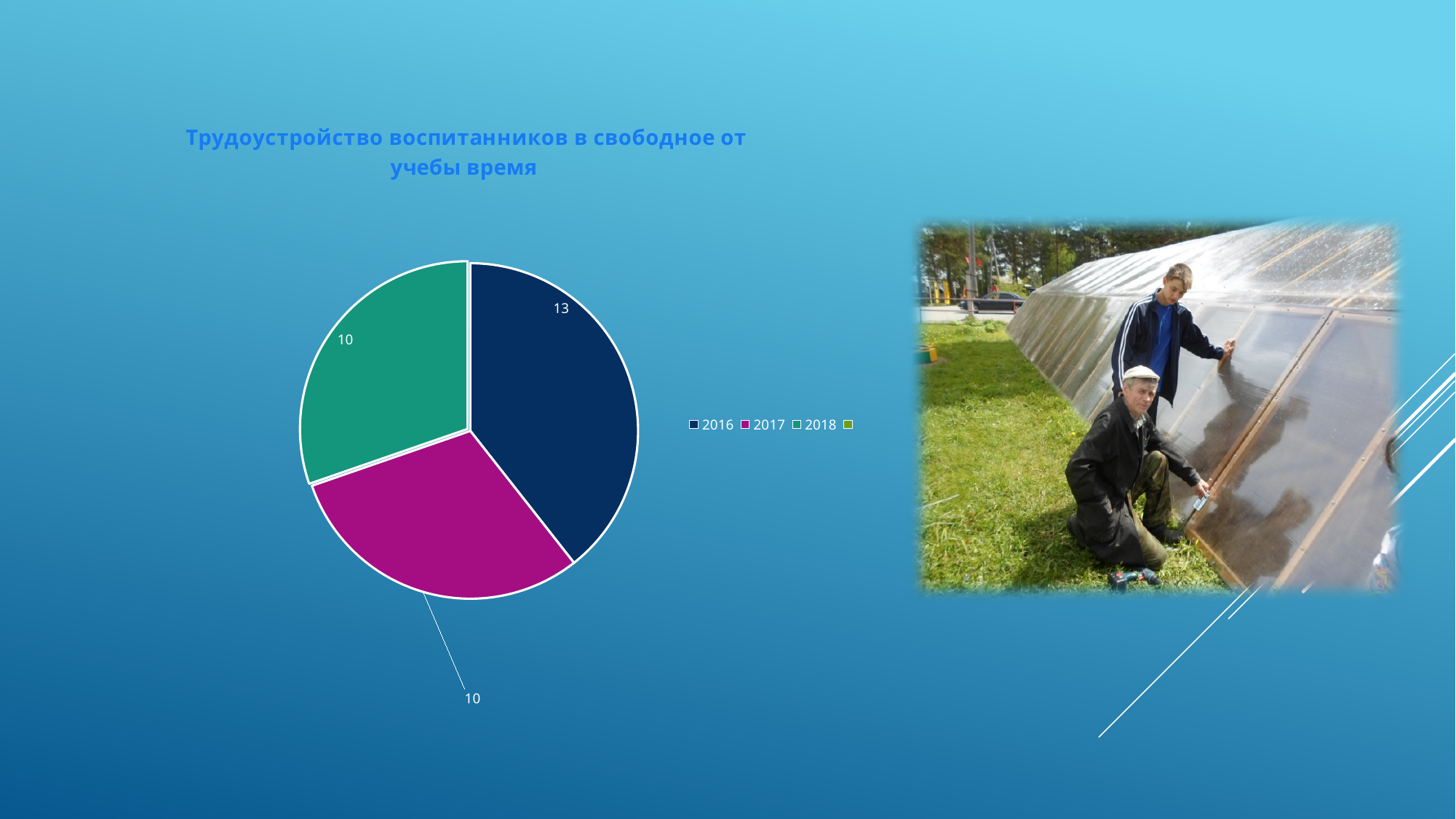
What is the difference between the values for 2016 and 2018? 3 What colour is the slice for 2017? magenta How many slices does the pie chart have? 3 Which year has the largest slice in the pie chart? 2016 What is the total of all the slices in the pie chart? 33 What is the value for 2016 in the pie chart? 13 What is the value for 2018 in the pie chart? 10 What type of chart is shown on the slide? pie chart Which is larger, the value for 2016 or the value for 2017? 2016 What is the value for 2017 in the pie chart? 10 What is the title of the chart? Трудоустройство воспитанников в свободное от учебы время Which is larger, the value for 2017 or the value for 2018? They are equal